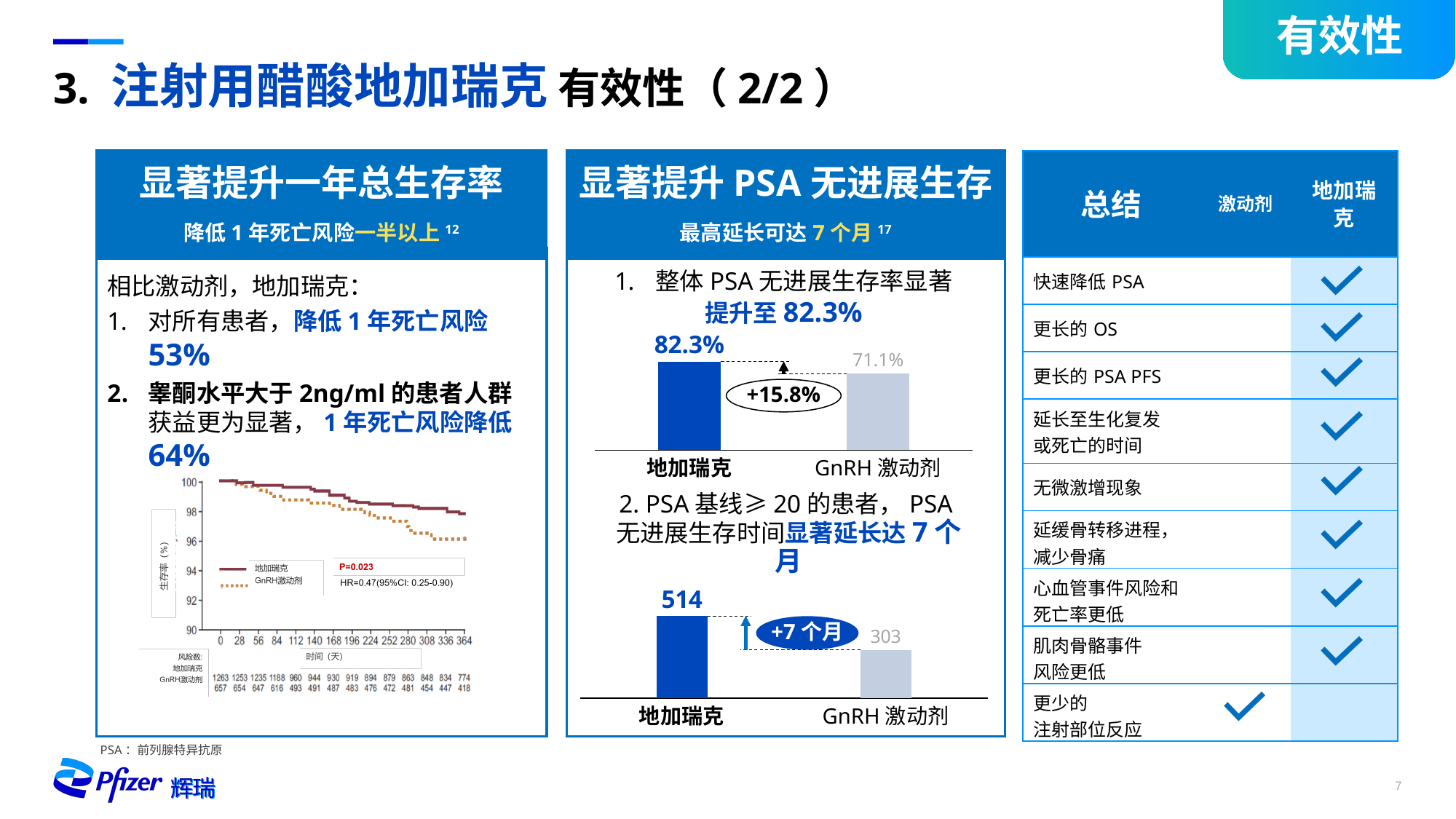
In the lower bar chart in the middle panel, which category has the lower value? GnRH 激动剂 How many bars does the lower bar chart in the middle panel have? 2 In the upper bar chart in the middle panel (PSA 无进展生存率), what is the value for 地加瑞克? 82.3% In the upper bar chart in the middle panel (PSA 无进展生存率), what is the value for GnRH 激动剂? 71.1% In the upper bar chart in the middle panel, which category has the higher value? 地加瑞克 In the line chart in the left panel, do the survival curves rise or fall as time (天) increases? Fall In the upper bar chart in the middle panel, what difference between the two bars is labelled on the chart? +15.8% How many series does the legend of the line chart in the left panel list? 2 What kind of chart is shown in the left panel below the text about 1 年死亡风险? Line chart In the lower bar chart in the middle panel (PSA 无进展生存时间), what is the value for GnRH 激动剂? 303 In the lower bar chart in the middle panel (PSA 无进展生存时间), what is the value for 地加瑞克? 514 In the lower bar chart in the middle panel, what is the difference between the 地加瑞克 bar and the GnRH 激动剂 bar? 211